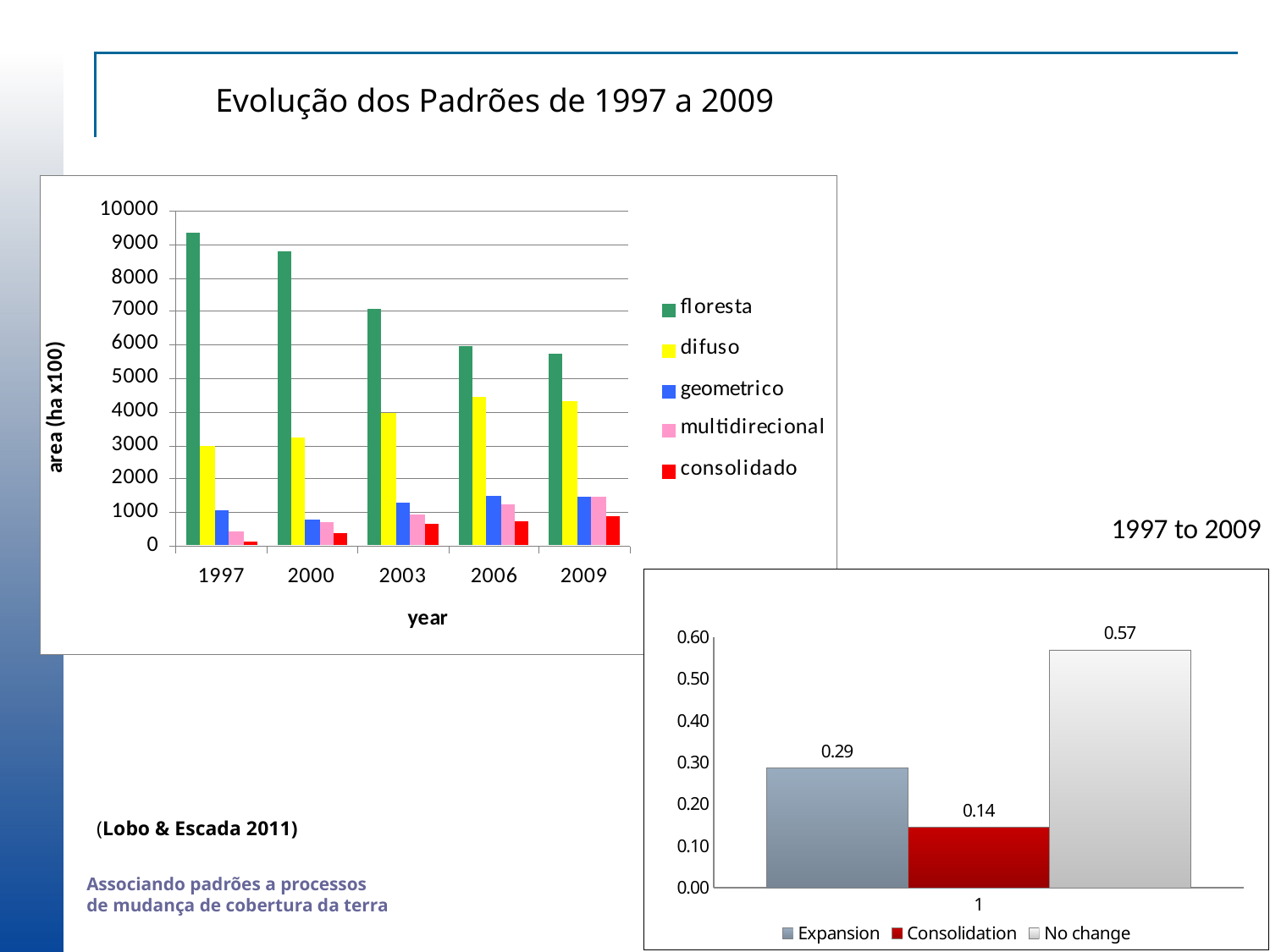
In the top-left chart, does the floresta series rise or fall from 1997 to 2009? fall In the top-left chart, what is the label of the y axis? area (ha x100) In the top-left chart, which series has the highest value in 2009? floresta In the top-left chart, how many series does the legend list? 5 In the bottom-right chart, what is the difference between No change and Expansion? 0.28 In the bottom-right chart, what is the value for Expansion? 0.29 In the top-left chart, which is larger in 2003, difuso or geometrico? difuso In the top-left chart, is the value for floresta in 1997 greater or less than 9000? greater In the top-left chart, is the value for consolidado in 1997 greater or less than 1000? less In the bottom-right chart, what is the value for Consolidation? 0.14 In the top-left chart, how many years are shown on the x axis? 5 In the bottom-right chart, which category has the highest value? No change